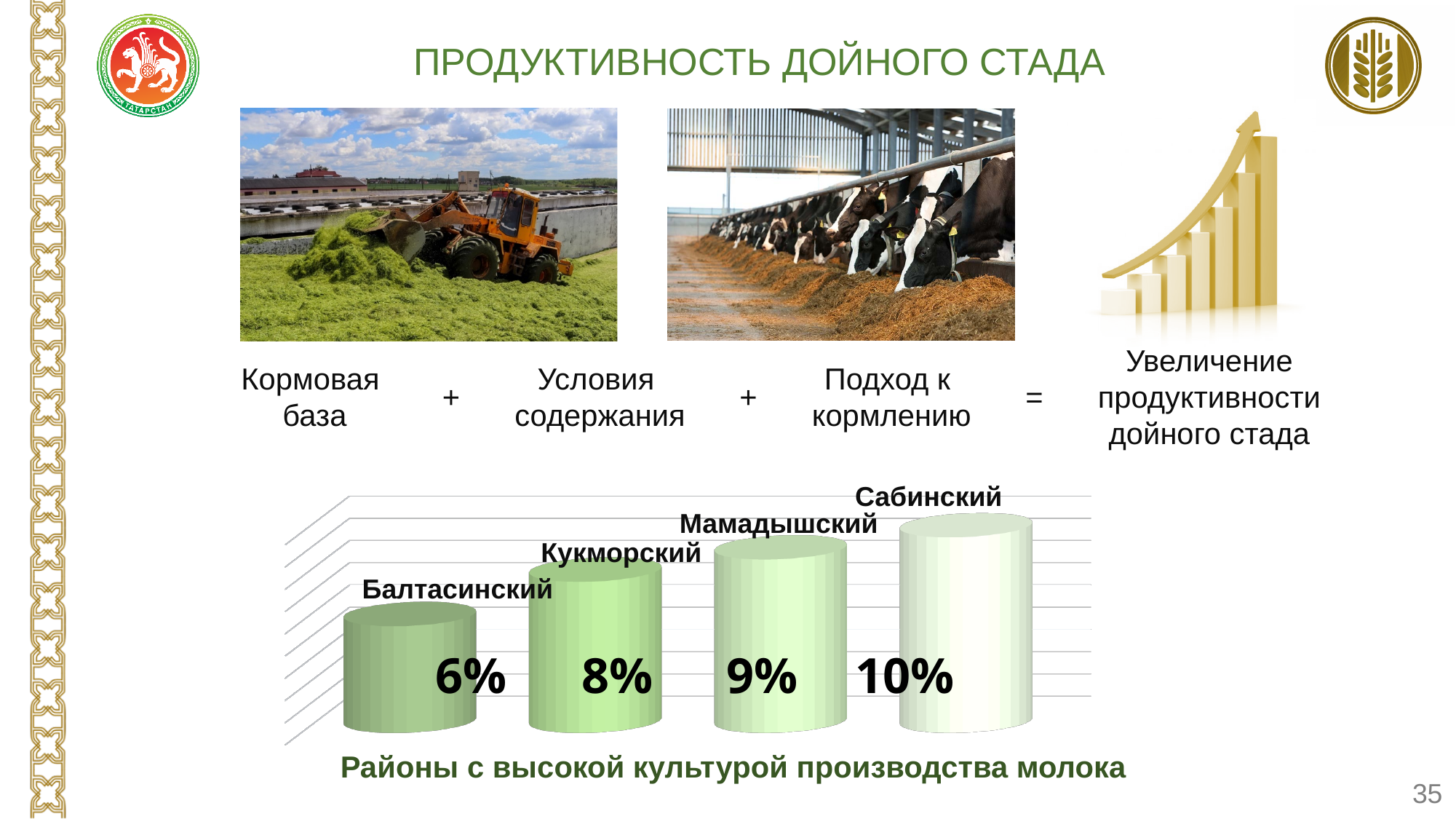
What is the caption printed below the chart? Районы с высокой культурой производства молока Which district has the highest value in the chart? Сабинский What is the value shown for Мамадышский? 9% What is the value shown for Балтасинский? 6% What is the value shown for Кукморский? 8% Which is larger, the value for Кукморский or the value for Мамадышский? Мамадышский What kind of chart is shown at the bottom of the slide? Bar chart What is the value shown for Сабинский? 10% How many districts are shown in the chart? 4 What is the difference between the values for Сабинский and Балтасинский? 4% What is the difference between the values for Мамадышский and Кукморский? 1% Which district has the lowest value in the chart? Балтасинский